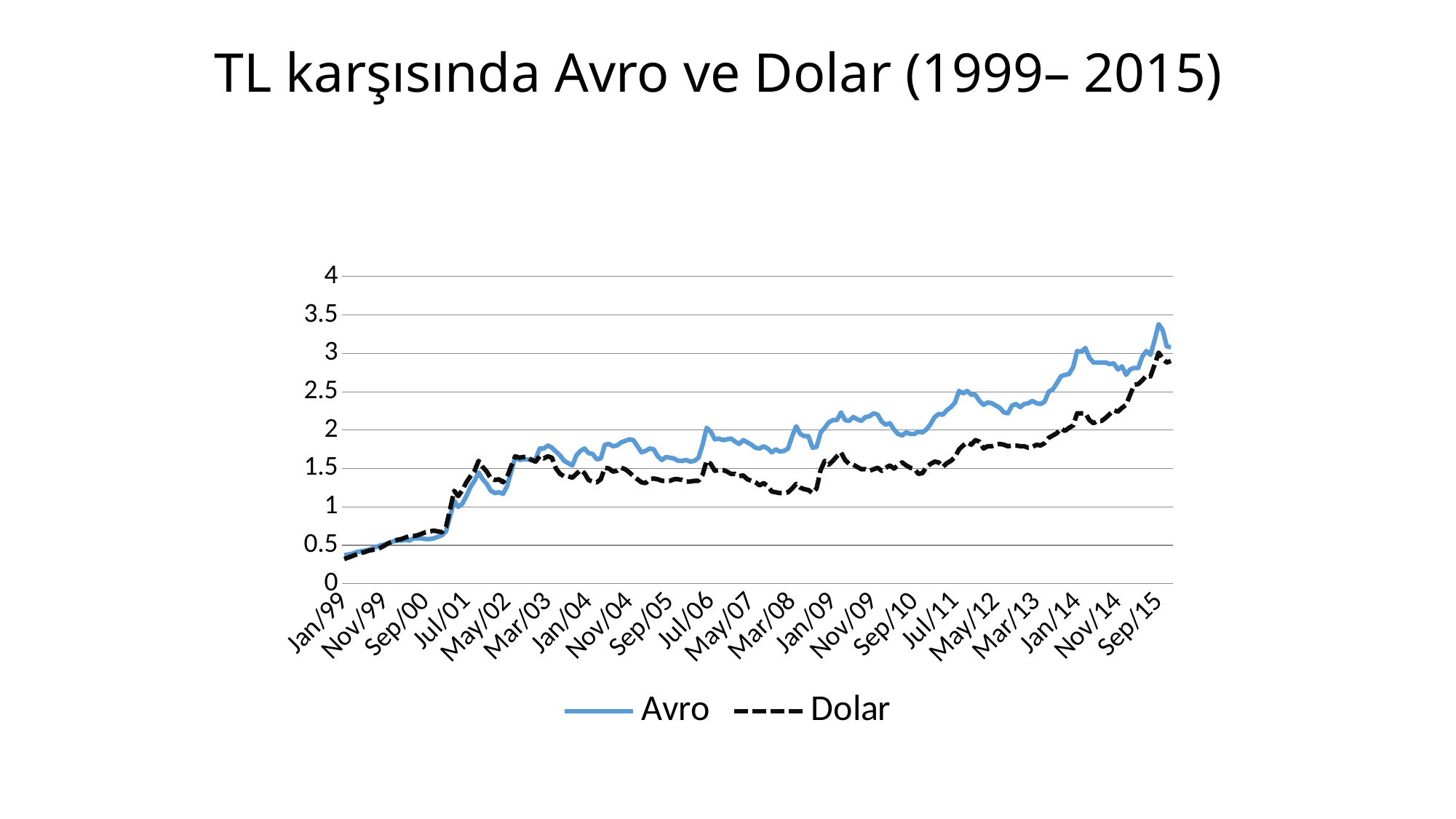
How many series does the legend list? 2 Is the value for Dolar at Mar/08 greater or less than 1.5? less Does the Avro series generally rise or fall from Jan/99 to Sep/15? Rise Which series reaches the highest value on the chart? Avro What kind of chart is shown on the slide? Line chart Is the value for Avro at Jul/11 greater or less than 2? greater Is the value for Avro at Sep/15 greater or less than 3? greater At Jan/14, which series has the higher value, Avro or Dolar? Avro Which series is drawn with a dashed line? Dolar Does the Dolar series generally rise or fall from Jan/99 to Sep/15? Rise What is the title of the chart? TL karşısında Avro ve Dolar (1999– 2015)